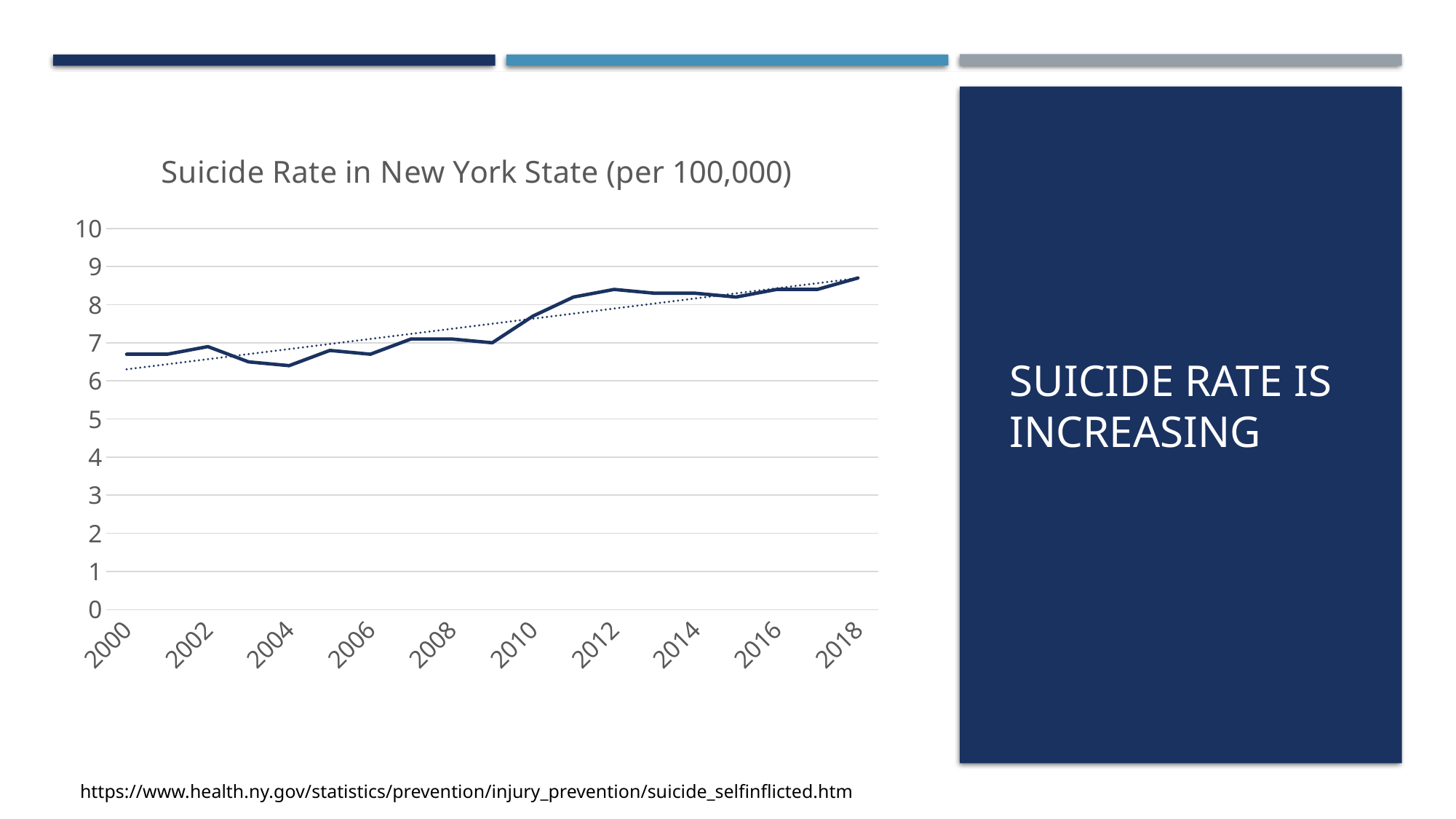
Is the value for 2004 greater or less than 7? less What is the highest value shown on the vertical axis? 10 Is the value for 2012 greater or less than 8? greater Which year has the highest suicide rate in the chart? 2018 Which year has the larger suicide rate, 2004 or 2012? 2012 Which year has the larger suicide rate, 2000 or 2018? 2018 What kind of chart is shown on the slide? line chart Is the value for 2018 greater or less than 8? greater What is the title of the chart? Suicide Rate in New York State (per 100,000) Overall, do the values in the chart rise or fall from 2000 to 2018? rise